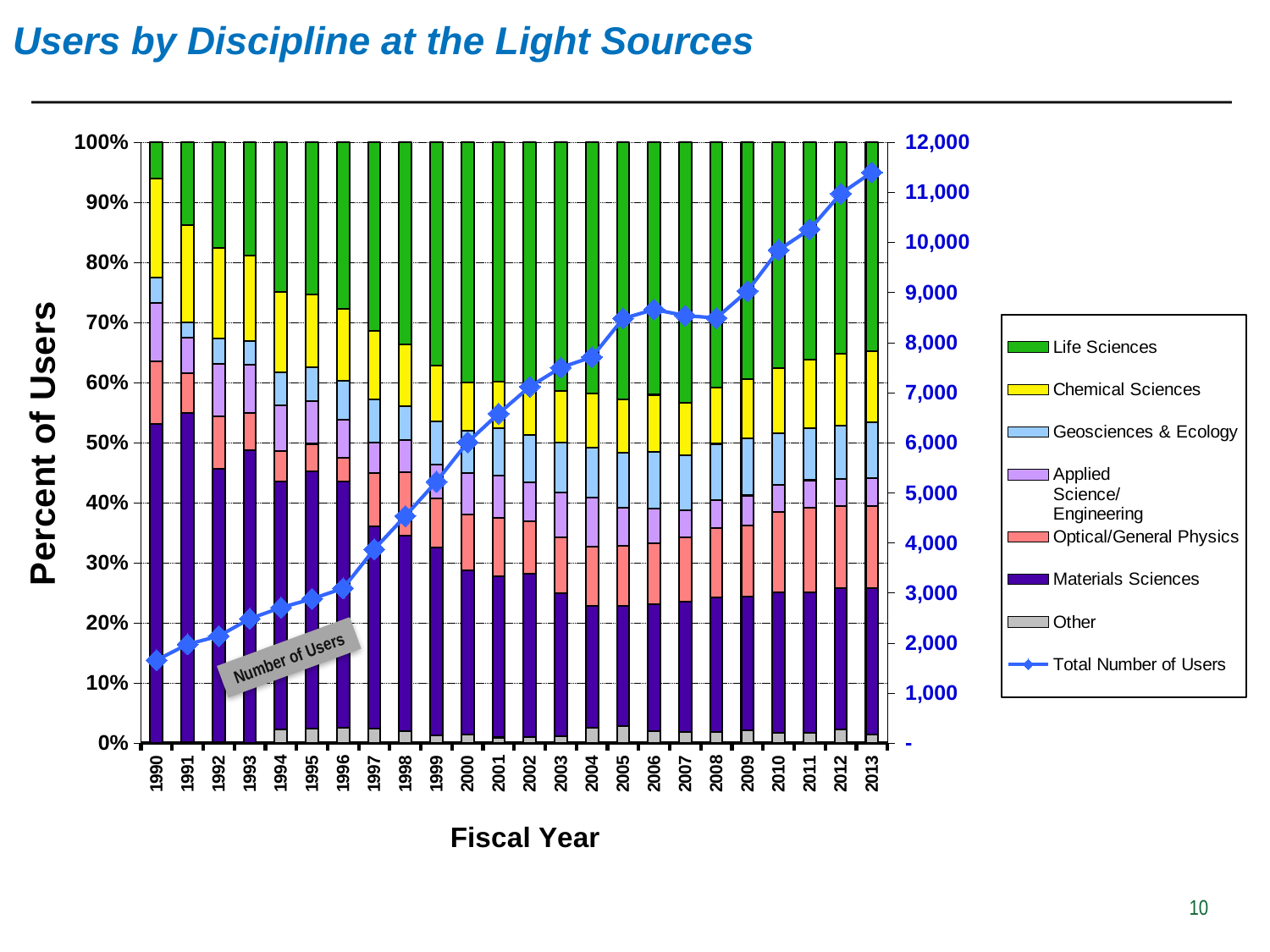
Is the Materials Sciences share of users in 1991 greater or less than 50%? greater How many fiscal years are shown on the x axis? 24 What kind of chart is shown on the slide? Stacked bar chart with a line Which is larger, the Total Number of Users in 2013 or in 1990? 2013 Is the Total Number of Users in 1990 greater or less than 2,000? less Is the Materials Sciences share of users in 2013 greater or less than 30%? less Which fiscal year has the lowest Total Number of Users? 1990 Which fiscal year has the highest Total Number of Users? 2013 How many entries does the legend list? 8 Does the Total Number of Users line rise or fall from 1990 to 2013? Rises What is the title of the chart? Users by Discipline at the Light Sources